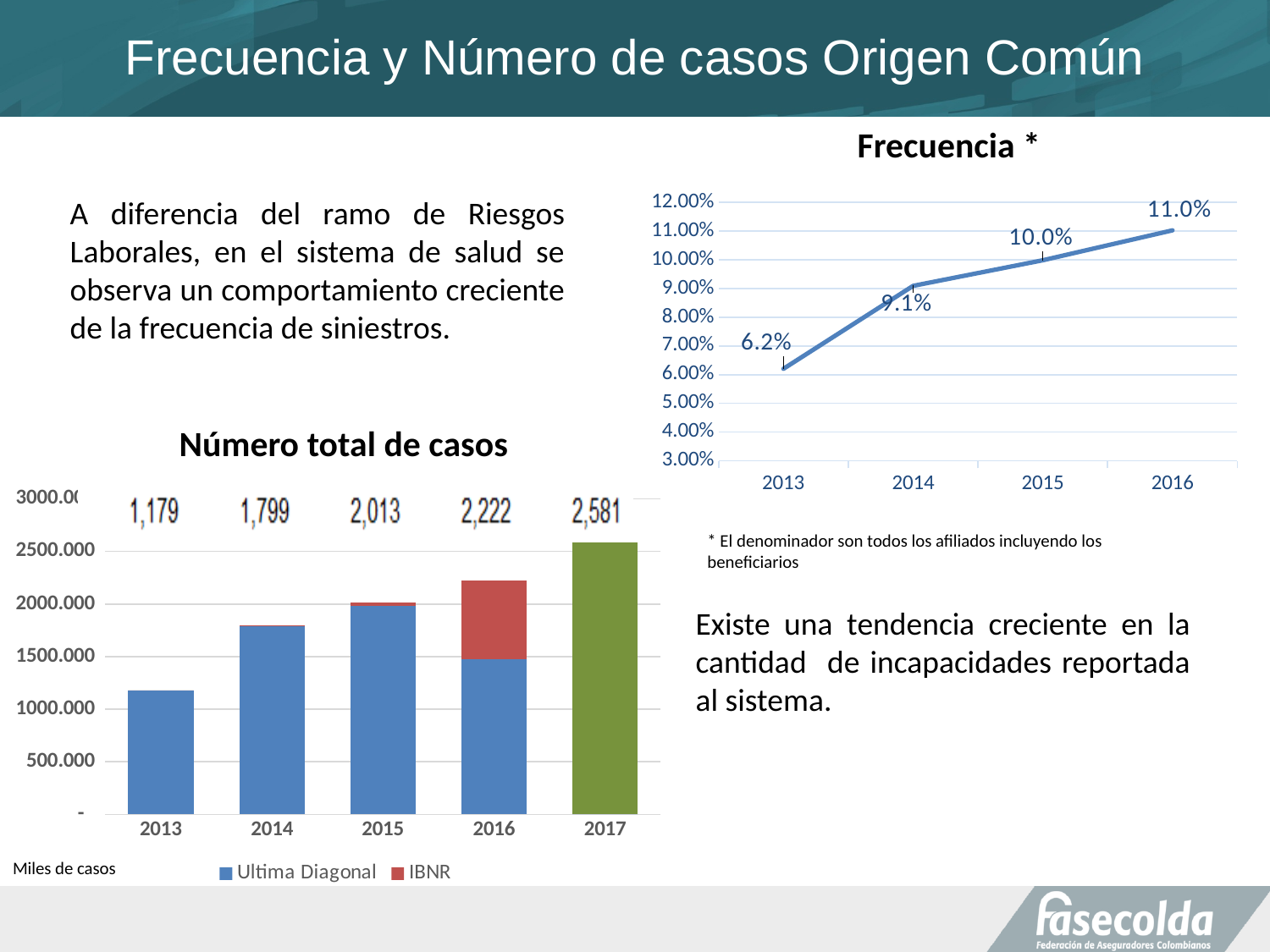
In the 'Número total de casos' chart, what is the total labelled for 2015? 2,013 In the 'Número total de casos' chart, how many years are shown on the x axis? 5 In the 'Número total de casos' chart, what is the total labelled for 2017? 2,581 In the 'Frecuencia *' chart, which year has the highest value? 2016 In the 'Número total de casos' chart, how many series does the legend list? 2 What kind of chart is the 'Frecuencia *' chart? line chart In the 'Frecuencia *' chart, what is the value for 2016? 11.0% In the 'Frecuencia *' chart, do the values rise or fall from 2013 to 2016? rise In the 'Número total de casos' chart, which is larger, the total for 2014 or the total for 2016? 2016 In the 'Frecuencia *' chart, which year has the lowest value? 2013 In the 'Frecuencia *' chart, what is the difference between the 2016 and 2015 values? 1.0% In the 'Frecuencia *' chart, what is the value for 2013? 6.2%